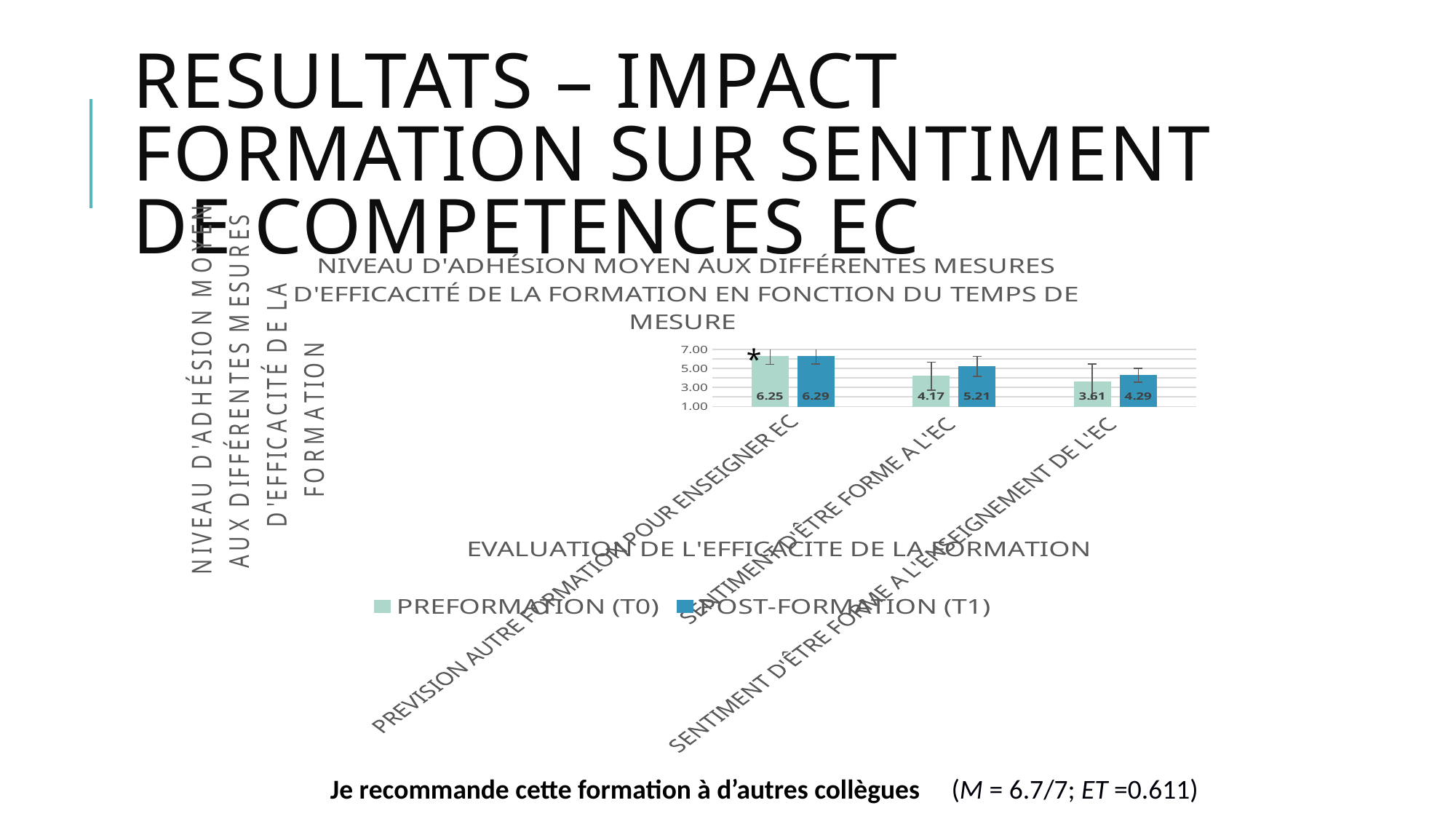
What is the difference between the POST-FORMATION (T1) and PREFORMATION (T0) values for SENTIMENT D'ÊTRE FORME A L'EC? 1.04 How many categories are shown on the x axis? 3 What is the POST-FORMATION (T1) value for SENTIMENT D'ÊTRE FORME A L'EC? 5.21 What type of chart is shown on the slide? bar chart What is the PREFORMATION (T0) value for SENTIMENT D'ÊTRE FORME A L'ENSEIGNEMENT DE L'EC? 3.61 What is the PREFORMATION (T0) value for PREVISION AUTRE FORMATION POUR ENSEIGNER EC? 6.25 What is the POST-FORMATION (T1) value for SENTIMENT D'ÊTRE FORME A L'ENSEIGNEMENT DE L'EC? 4.29 For SENTIMENT D'ÊTRE FORME A L'ENSEIGNEMENT DE L'EC, which is larger: the PREFORMATION (T0) value or the POST-FORMATION (T1) value? POST-FORMATION (T1) Which legend entry is shown in the darker blue colour? POST-FORMATION (T1) How many series does the legend list? 2 Which category has the lowest PREFORMATION (T0) value? SENTIMENT D'ÊTRE FORME A L'ENSEIGNEMENT DE L'EC Which category has the highest POST-FORMATION (T1) value? PREVISION AUTRE FORMATION POUR ENSEIGNER EC